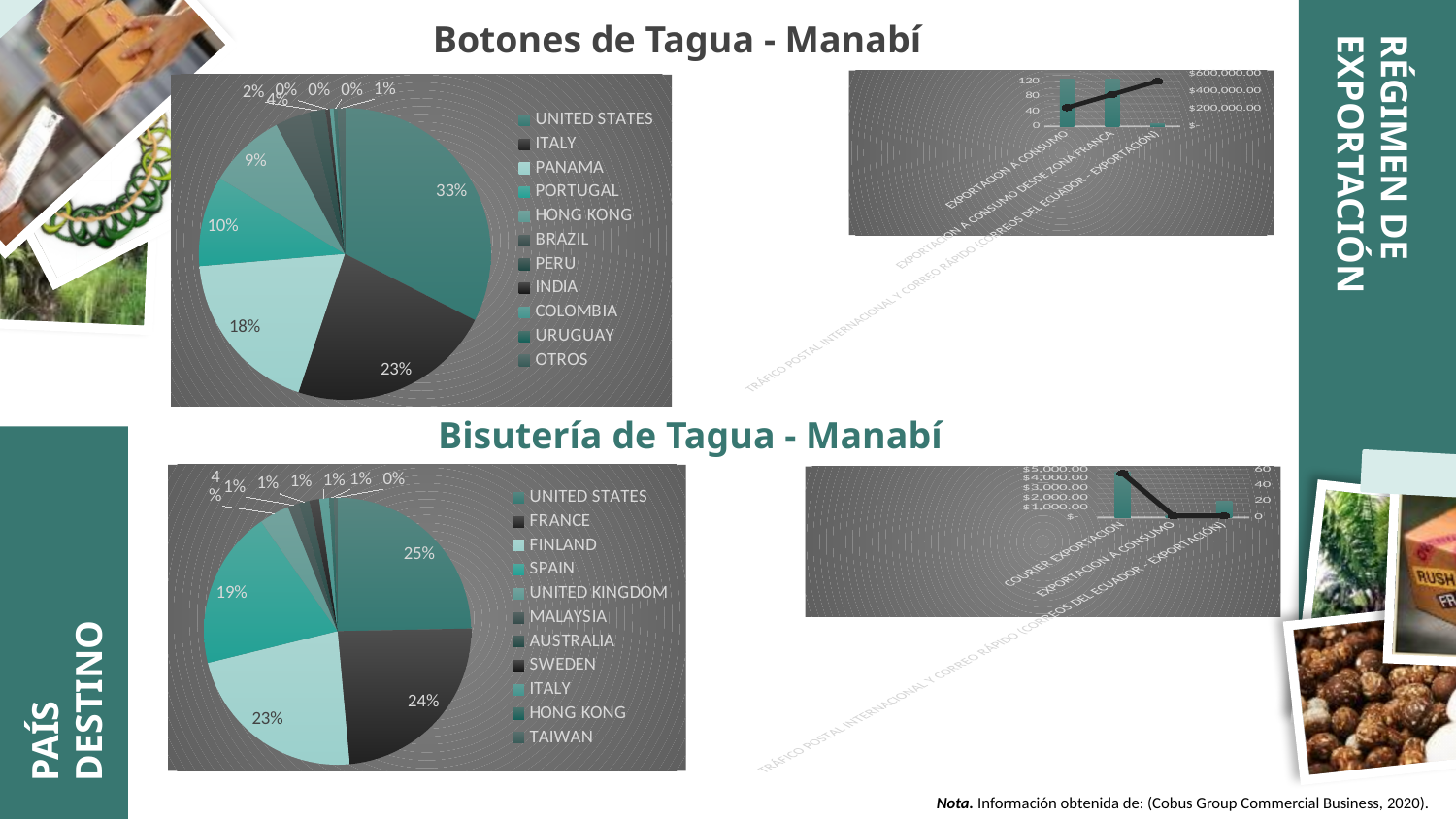
What kind of chart is used for 'Bisutería de Tagua - Manabí' on the left of the slide? Pie chart How many entries does the legend of the 'Botones de Tagua - Manabí' pie chart list? 11 In the 'Bisutería de Tagua - Manabí' pie chart, which country has the largest share? UNITED STATES In the 'Bisutería de Tagua - Manabí' pie chart, which country is listed last in the legend? TAIWAN In the 'Bisutería de Tagua - Manabí' pie chart, what share does UNITED STATES have? 25% In the 'Botones de Tagua - Manabí' pie chart, what share does ITALY have? 23% In the 'Botones de Tagua - Manabí' pie chart, which country has the largest share? UNITED STATES In the 'Bisutería de Tagua - Manabí' pie chart, what is the difference between the shares of FRANCE and SPAIN? 5% In the 'Bisutería de Tagua - Manabí' pie chart, what share does SPAIN have? 19% In the 'Botones de Tagua - Manabí' pie chart, what is the difference between the shares of UNITED STATES and PANAMA? 15% In the 'Botones de Tagua - Manabí' pie chart, which is larger, the share of PORTUGAL or the share of HONG KONG? PORTUGAL In the 'Botones de Tagua - Manabí' pie chart, what share does UNITED STATES have? 33%